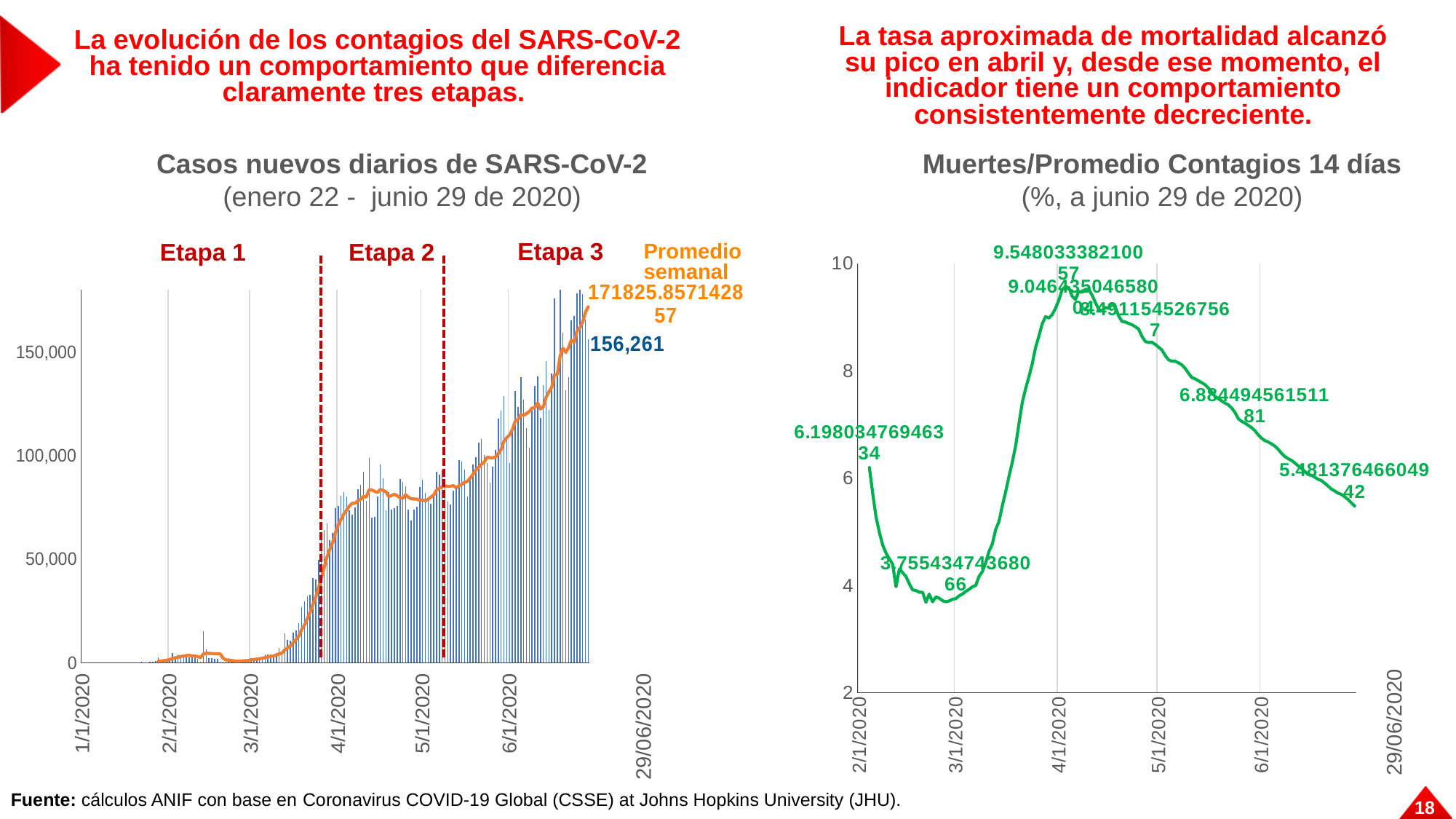
In the right chart, what is the labelled value at the start of the series (2/1/2020)? 6.19803476946334 In the right chart, what is the lowest labelled value of the indicator? 3.75543474368066 In the right chart, does the indicator rise or fall between 4/1/2020 and 29/06/2020? fall In the left chart, which is larger at the end of the series: the daily new cases value (156,261) or the weekly average (171825.857142857)? the weekly average (171825.857142857) In the right chart (Muertes/Promedio Contagios 14 días), what kind of chart is shown? line chart In the right chart, is the value at 5/1/2020 greater or less than 8? greater In the right chart, what is the labelled peak value of the mortality indicator? 9.54803338210057 In the left chart, what is the labelled value of daily new cases at the end of the series (29/06/2020)? 156,261 In the left chart, what is the labelled value of the weekly average (Promedio semanal) at the end of the series? 171825.857142857 In the right chart, what is the labelled value at the end of the series (29/06/2020)? 5.48137646604942 In the left chart, what kind of chart is used to show the daily new cases? bar chart How many stages (Etapas) are marked on the left chart? 3